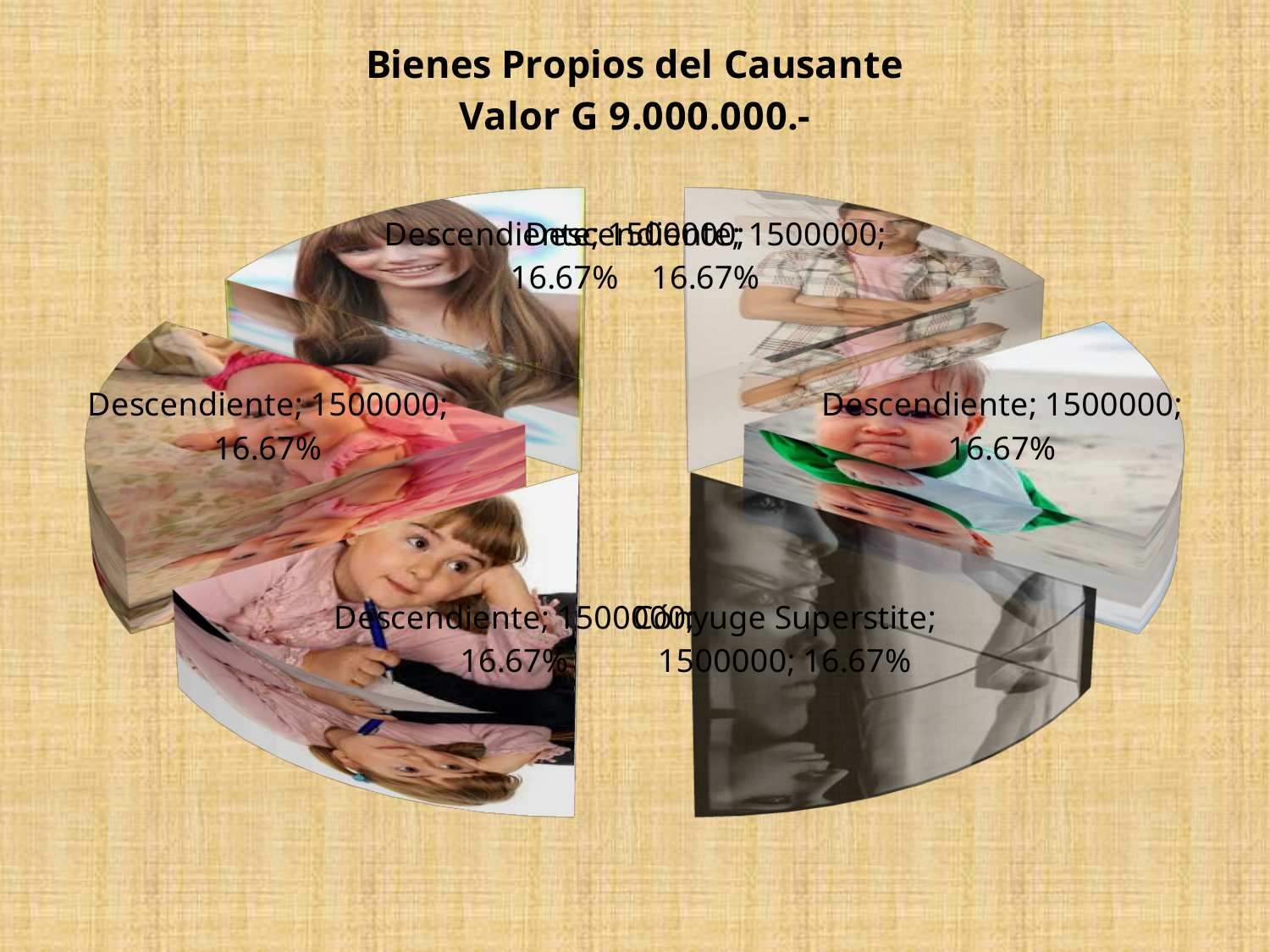
What value is shown for the Conyuge Superstite slice? 1500000 How many slices does the pie chart have? 6 Is the value for the Conyuge Superstite slice larger than, smaller than, or equal to the value for a Descendiente slice? equal Besides Descendiente, what other category label appears on the pie chart? Conyuge Superstite What kind of chart is shown on the slide? pie chart What value is shown for each Descendiente slice? 1500000 What percentage is shown on each Descendiente slice? 16.67% What share of the pie does the Conyuge Superstite slice represent? 16.67% What is the title of the chart? Bienes Propios del Causante Valor G 9.000.000.- How many slices are labelled Descendiente? 5 What is the difference between the value of the Conyuge Superstite slice and the value of a Descendiente slice? 0